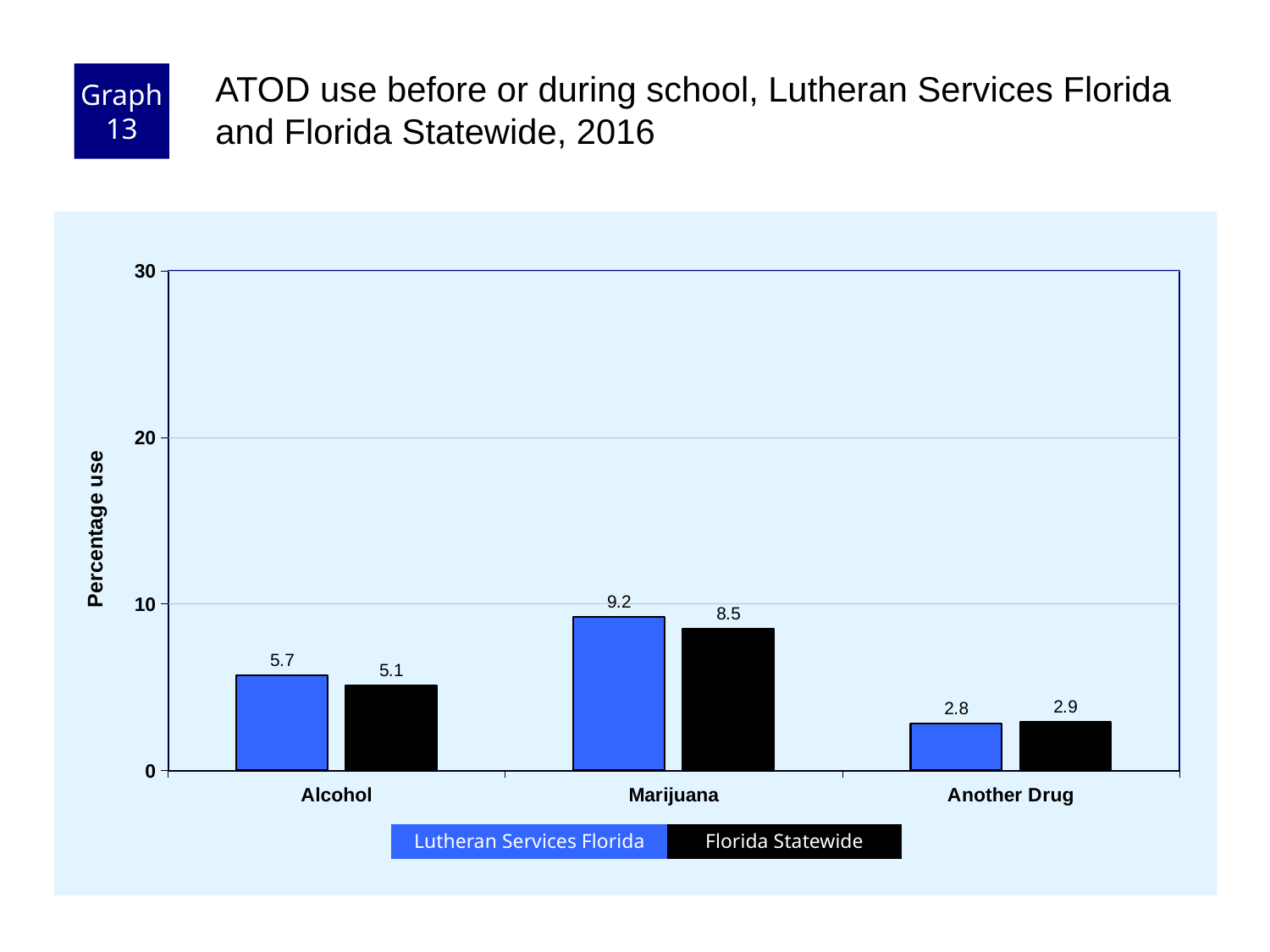
Which category has the lowest Florida Statewide value? Another Drug What is the Lutheran Services Florida value for Alcohol? 5.7 What is the difference between the Lutheran Services Florida and Florida Statewide values for Marijuana? 0.7 Is the Lutheran Services Florida value for Marijuana greater or less than 10? less What kind of chart is shown on the slide? bar chart What is the Lutheran Services Florida value for Another Drug? 2.8 Which category has the highest Lutheran Services Florida value? Marijuana What is the Florida Statewide value for Marijuana? 8.5 How many series does the legend list? 2 What is the label of the y axis? Percentage use How many categories are shown on the x axis? 3 Which is larger for Alcohol: Lutheran Services Florida or Florida Statewide? Lutheran Services Florida